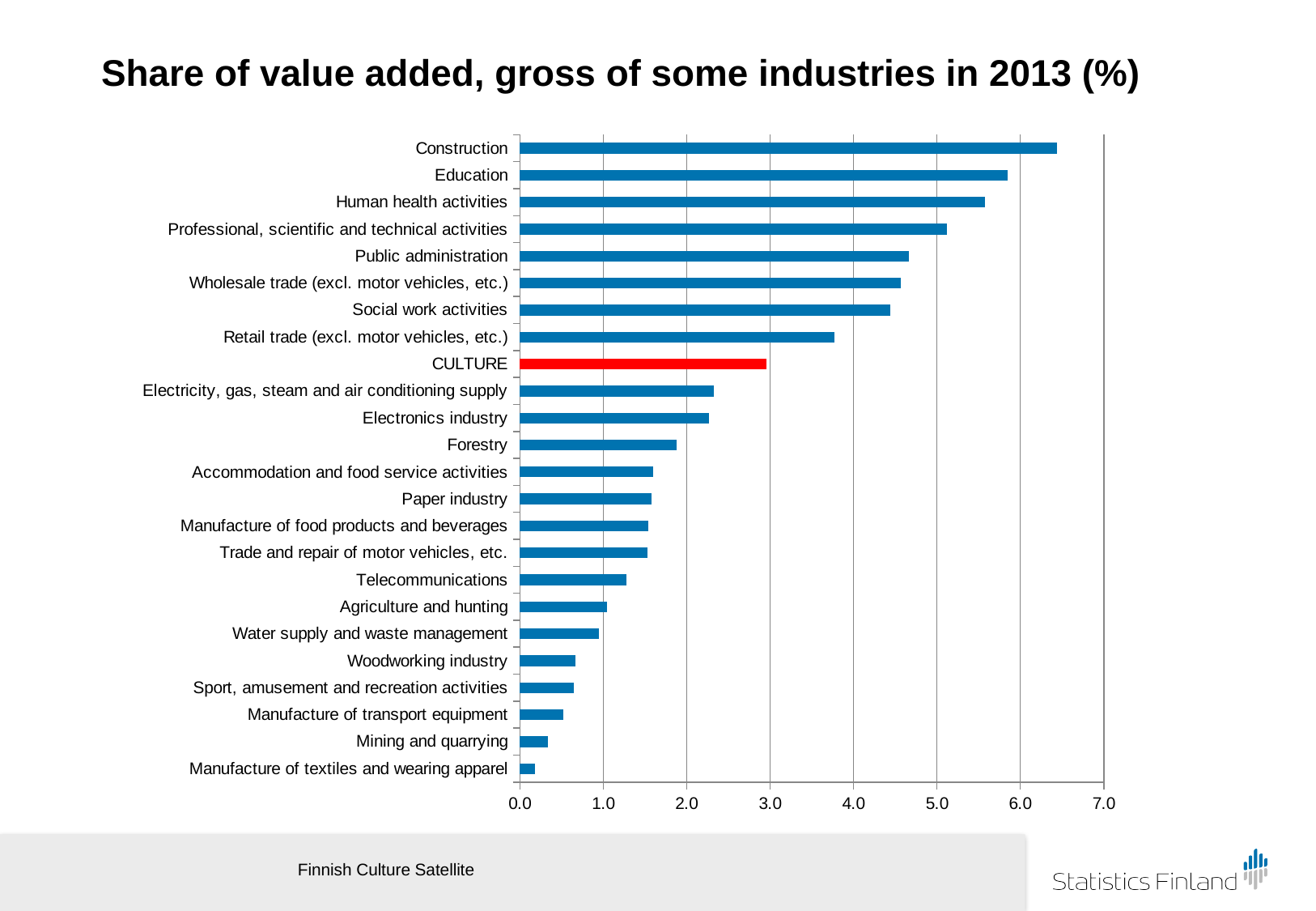
Is the value for Mining and quarrying greater or less than 1.0? less How many industries are listed in the chart? 24 Do the bar values increase or decrease from the top of the chart to the bottom? decrease Which has a larger share of value added, Construction or Education? Construction Is the value for Retail trade (excl. motor vehicles, etc.) greater or less than 3.0? greater Is the value for Construction greater or less than 6.0? greater Which has a larger share of value added, CULTURE or Retail trade (excl. motor vehicles, etc.)? Retail trade (excl. motor vehicles, etc.) What kind of chart is shown on the slide? Bar chart Which industry has the highest share of value added in the chart? Construction Which industry has the lowest share of value added in the chart? Manufacture of textiles and wearing apparel Which industry's bar is highlighted in red? CULTURE